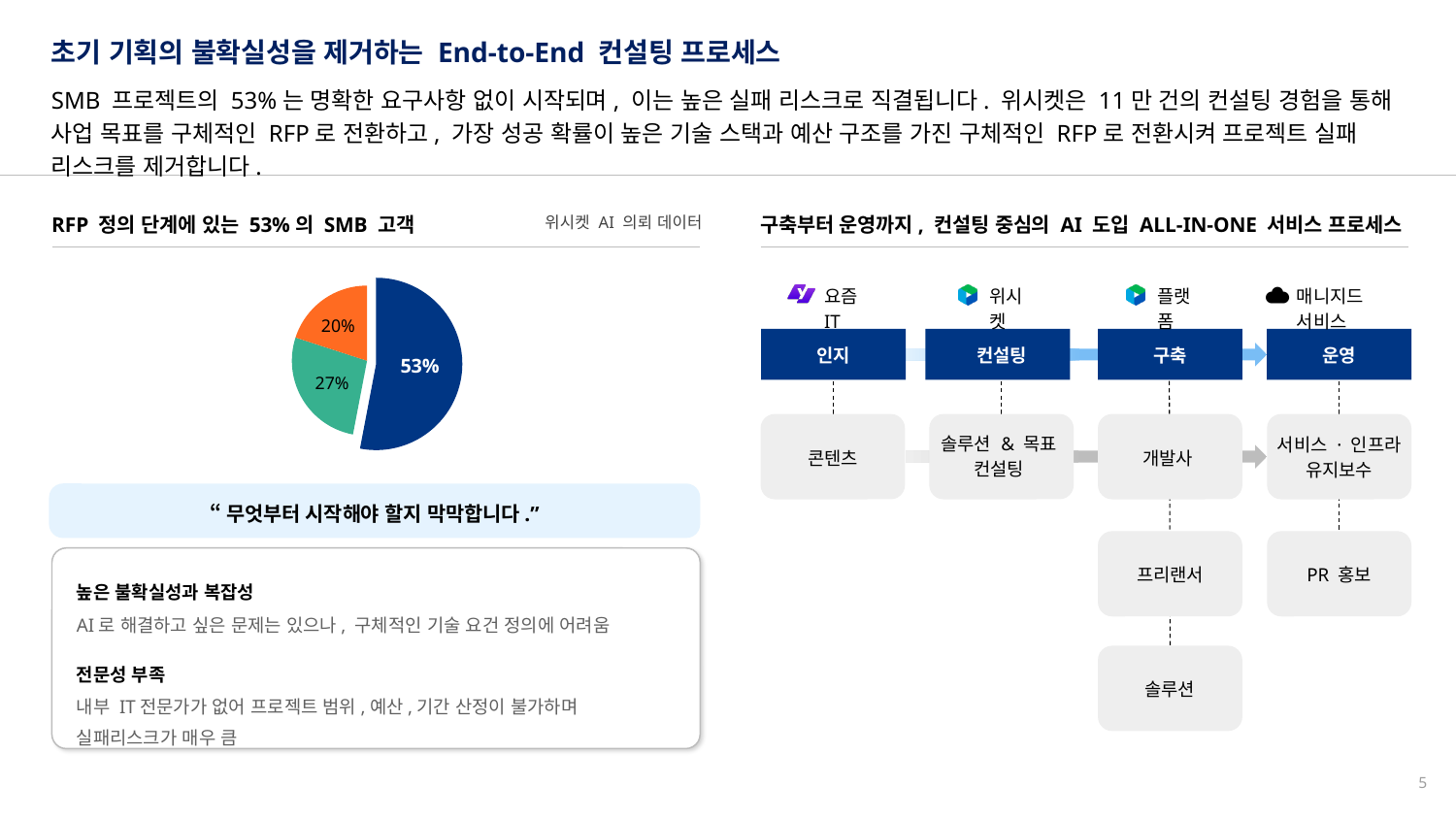
What data source is cited next to the pie chart's title? 위시켓 AI 의뢰 데이터 Which slice of the pie chart is larger, the green one or the orange one? the green one (27%) What value is labelled on the green slice of the pie chart? 27% What kind of chart is shown under the heading "RFP 정의 단계에 있는 53%의 SMB 고객"? pie chart What is the difference between the largest slice (53%) and the green slice (27%) in the pie chart? 26% What percentage is shown on the smallest slice of the pie chart? 20% What value is labelled on the orange slice of the pie chart? 20% What percentage is shown on the largest slice of the pie chart? 53% Which slice of the pie chart is pulled out (exploded) from the rest? the dark blue 53% slice How many slices does the pie chart have? 3 What is the difference between the green slice (27%) and the orange slice (20%) in the pie chart? 7% What value is labelled on the dark blue slice of the pie chart? 53%